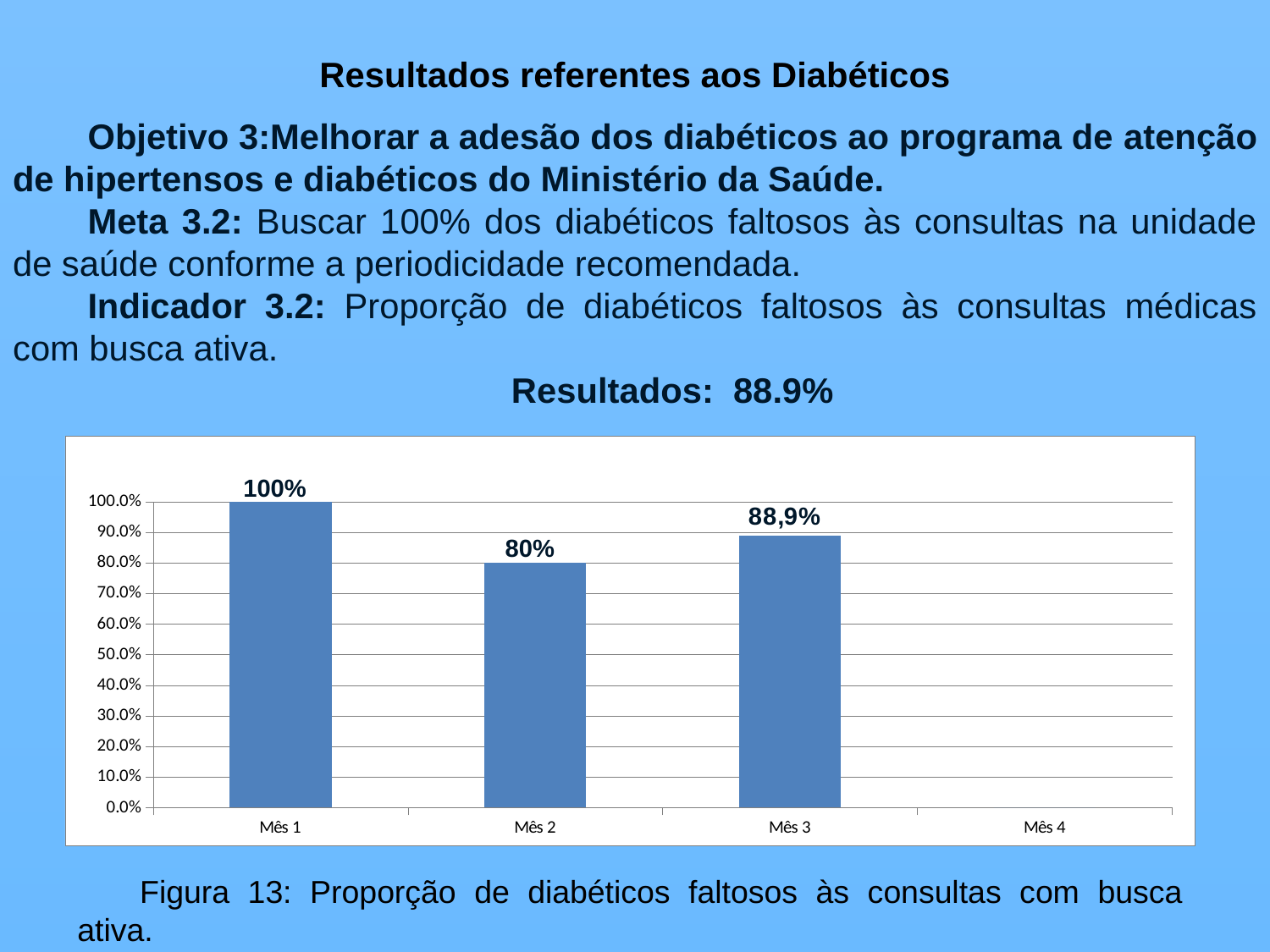
How many categories are shown on the x axis? 4 What is the value for Mês 2? 80% Which category on the x axis has no bar plotted? Mês 4 What kind of chart is shown on the slide? Bar chart What is the figure caption below the chart? Figura 13: Proporção de diabéticos faltosos às consultas com busca ativa. Which month with a plotted bar has the lowest value? Mês 2 Which is larger, the value for Mês 2 or the value for Mês 3? Mês 3 Is the value for Mês 3 greater or less than 80.0%? greater Which month has the highest value? Mês 1 What is the value for Mês 3? 88,9% What is the value for Mês 1? 100% Does the value rise or fall from Mês 1 to Mês 2? Fall